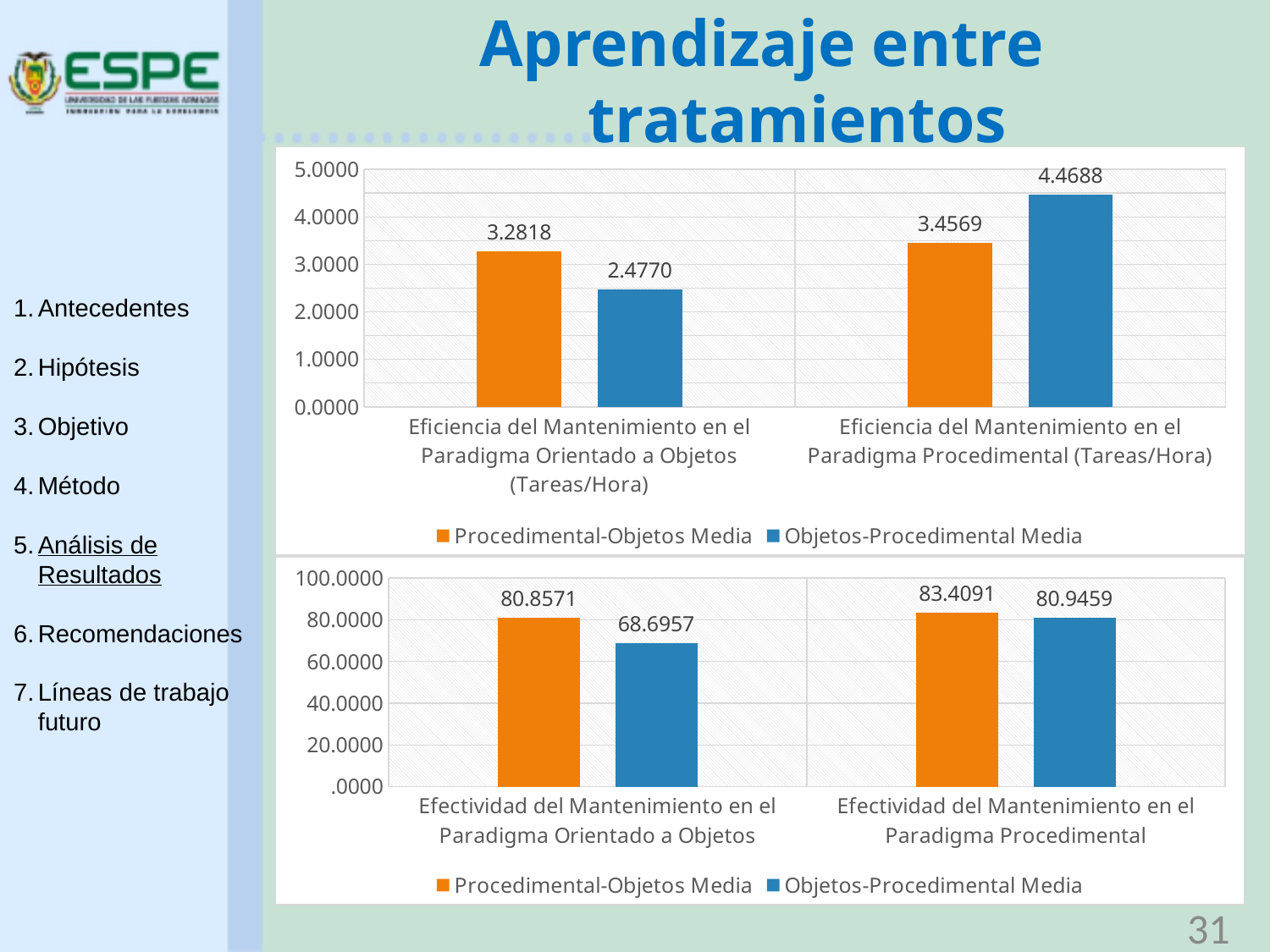
In the top chart, which bar has the lowest value? Objetos-Procedimental Media for Eficiencia del Mantenimiento en el Paradigma Orientado a Objetos (Tareas/Hora) What type of chart is the bottom chart? Bar chart In the bottom chart, what is the value of Procedimental-Objetos Media for Efectividad del Mantenimiento en el Paradigma Procedimental? 83.4091 In the top chart, what is the difference between Procedimental-Objetos Media and Objetos-Procedimental Media for Eficiencia del Mantenimiento en el Paradigma Orientado a Objetos (Tareas/Hora)? 0.8048 How many series does the legend of the top chart list? 2 In the bottom chart, what is the difference between Procedimental-Objetos Media and Objetos-Procedimental Media for Efectividad del Mantenimiento en el Paradigma Orientado a Objetos? 12.1614 In the top chart, which colour represents Objetos-Procedimental Media? Blue In the top chart, what is the value of Procedimental-Objetos Media for Eficiencia del Mantenimiento en el Paradigma Orientado a Objetos (Tareas/Hora)? 3.2818 In the bottom chart, which is larger for Efectividad del Mantenimiento en el Paradigma Procedimental: Procedimental-Objetos Media or Objetos-Procedimental Media? Procedimental-Objetos Media In the bottom chart, what is the value of Objetos-Procedimental Media for Efectividad del Mantenimiento en el Paradigma Orientado a Objetos? 68.6957 In the top chart, what is the value of Objetos-Procedimental Media for Eficiencia del Mantenimiento en el Paradigma Procedimental (Tareas/Hora)? 4.4688 In the top chart, which bar has the highest value? Objetos-Procedimental Media for Eficiencia del Mantenimiento en el Paradigma Procedimental (Tareas/Hora)